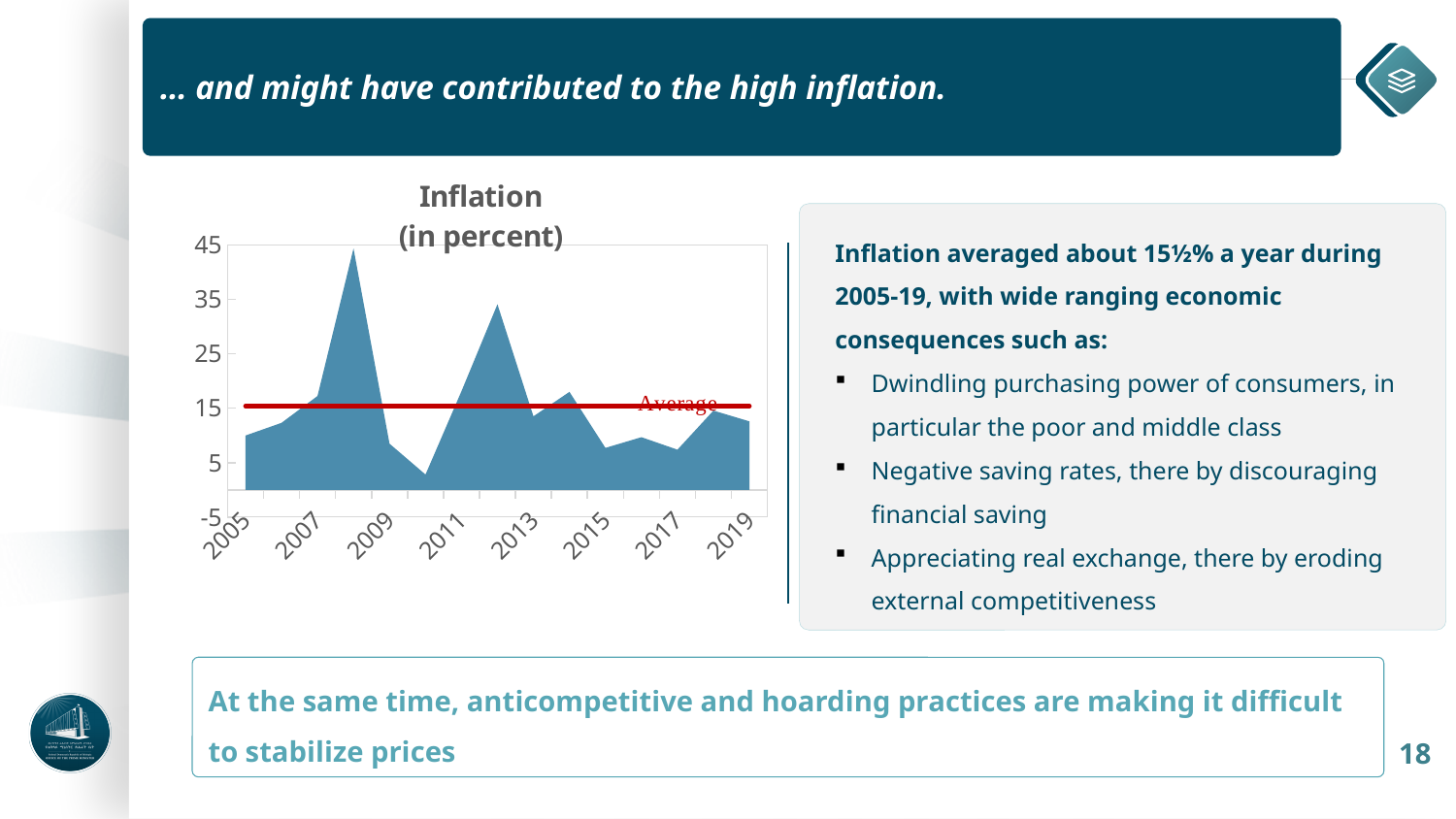
Which year has higher inflation, 2008 or 2012? 2008 What does the red horizontal line on the chart represent? Average Is the inflation value for 2012 greater or less than 25? greater Is the inflation value for 2005 greater or less than 15? less Is the inflation value for 2010 greater or less than 5? less How many year labels are shown on the x axis? 8 What is the title of the chart? Inflation (in percent) Does inflation rise or fall between 2008 and 2010? fall In which year does inflation reach its highest value? 2008 What kind of chart is shown on the slide? area chart In which year does inflation reach its lowest value? 2010